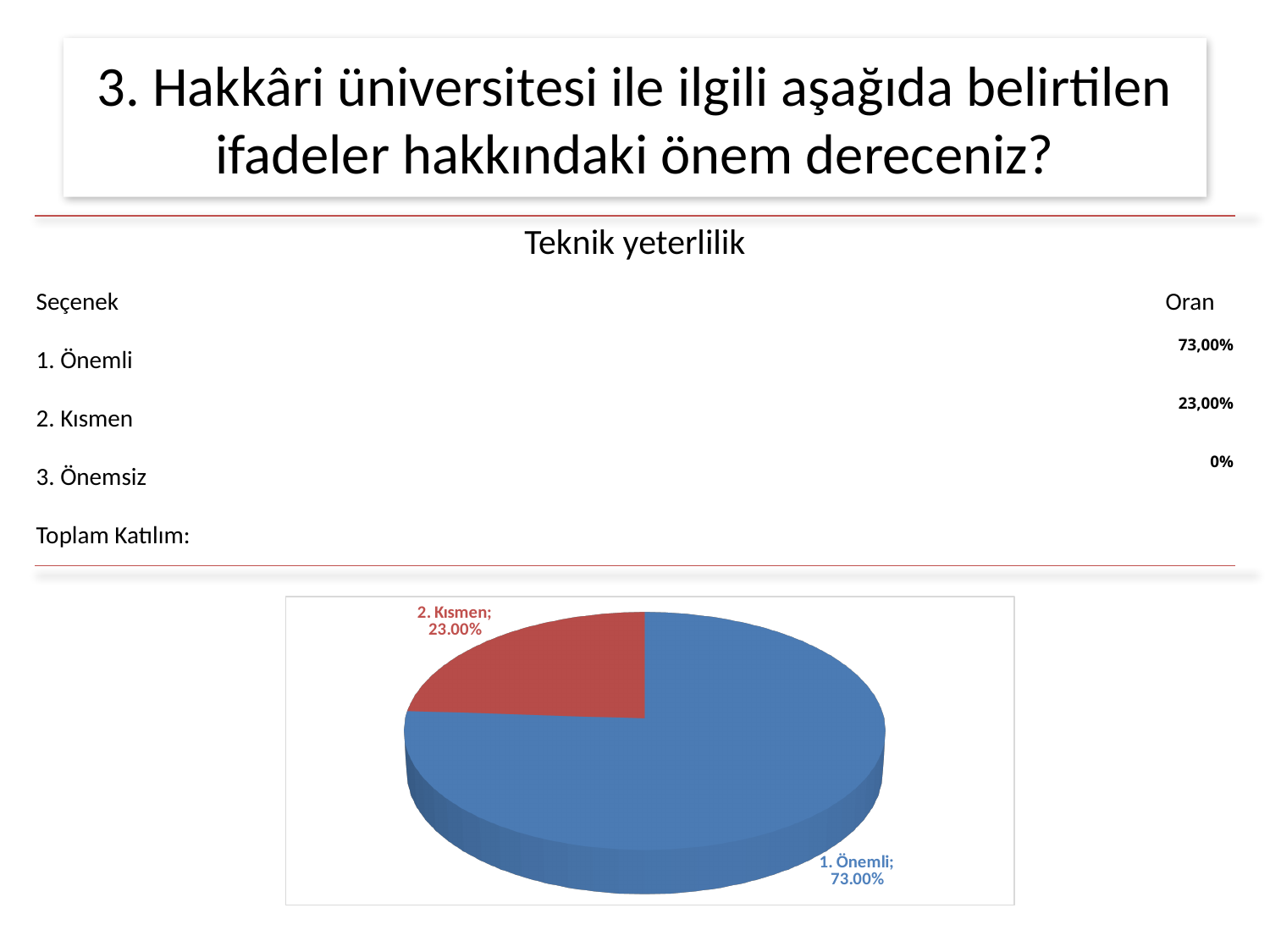
Which slice of the pie chart is the largest? 1. Önemli What share of the pie chart does the slice labelled "1. Önemli" represent? 73.00% What is the difference between the share for "1. Önemli" and the share for "2. Kısmen" in the pie chart? 50.00% Is the share for "1. Önemli" in the pie chart greater or less than 50%? greater Which labelled slice of the pie chart is the smallest? 2. Kısmen What colour is the "1. Önemli" slice in the pie chart? blue How many slices are labelled on the pie chart? 2 What share of the pie chart does the slice labelled "2. Kısmen" represent? 23.00% What kind of chart is shown on the slide? pie chart Which is larger in the pie chart, the share for "1. Önemli" or the share for "2. Kısmen"? 1. Önemli Is the share for "2. Kısmen" in the pie chart greater or less than 50%? less What colour is the "2. Kısmen" slice in the pie chart? red